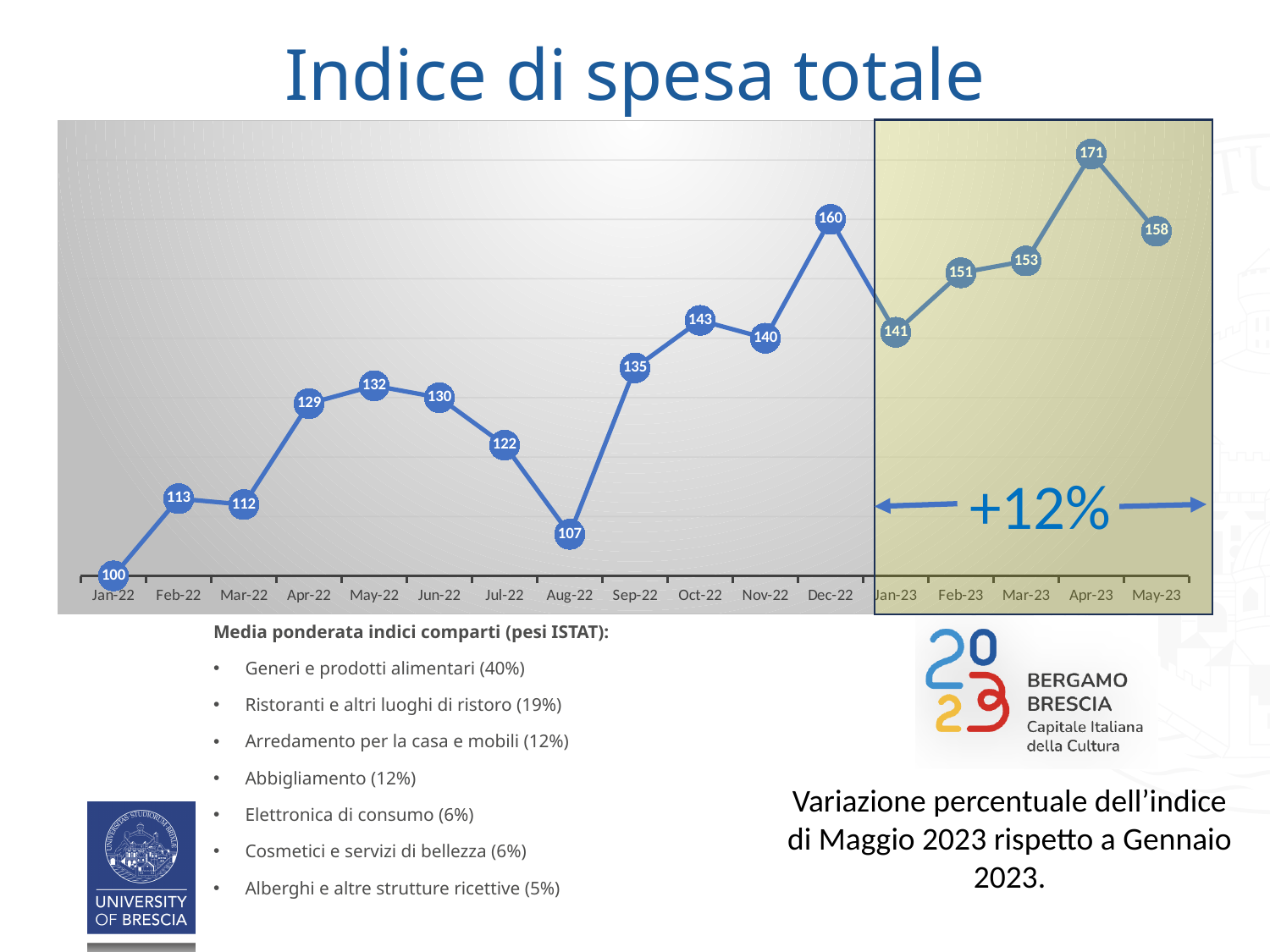
Which month has the lowest index value? Jan-22 What is the value of the index for Aug-22? 107 What kind of chart is shown on the slide? Line chart Which month has the highest index value? Apr-23 What is the title of the chart? Indice di spesa totale What is the value of the index for Dec-22? 160 How many data points are plotted on the chart? 17 Does the index rise or fall from Jan-22 to Apr-22? Rise What is the difference between the index values for Apr-23 and Jan-23? 30 What is the difference between the index values for Dec-22 and Nov-22? 20 What is the value of the index for May-23? 158 Which is larger, the index value for Feb-22 or for Mar-22? Feb-22